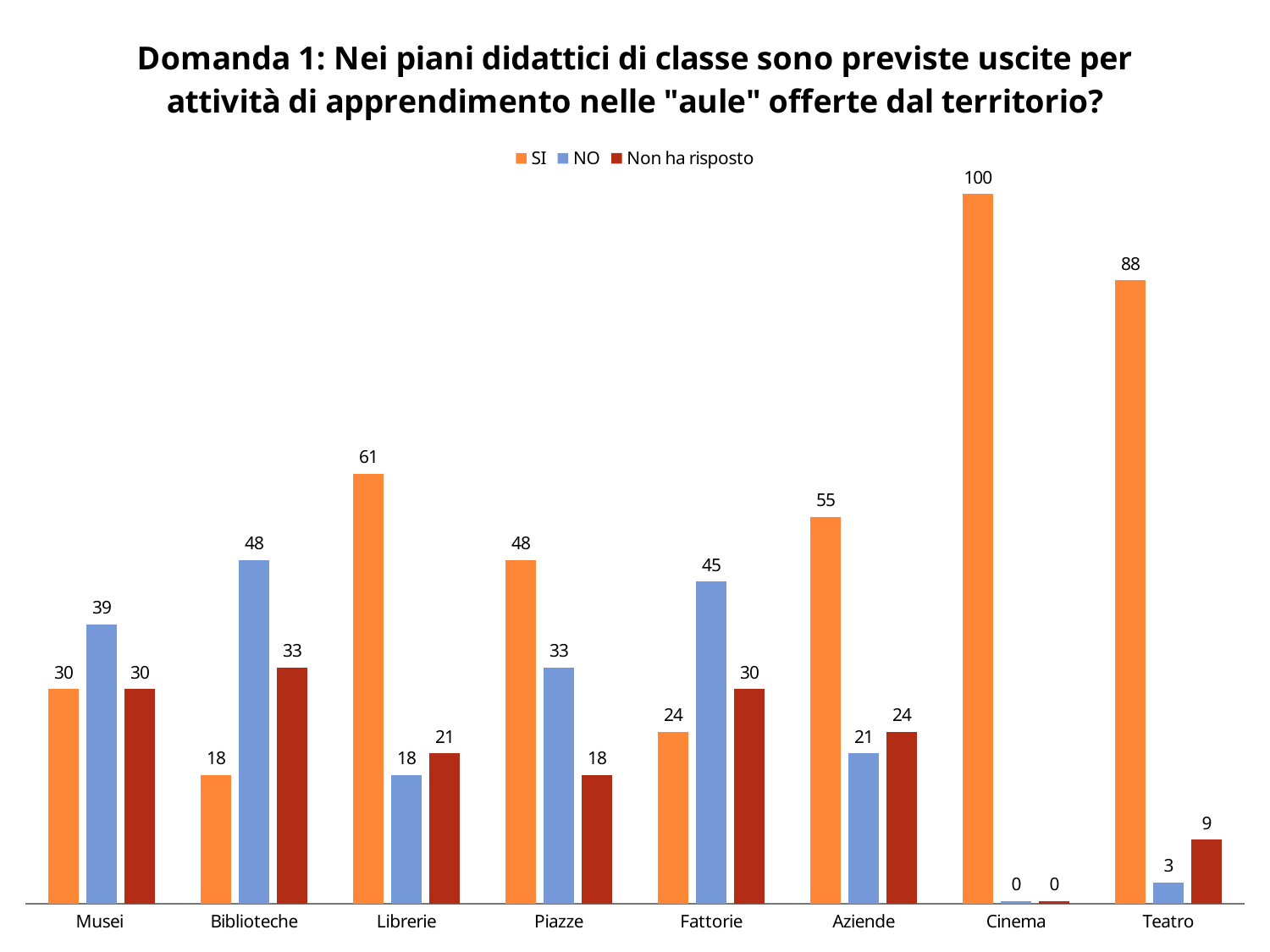
What is the difference between the SI value for Teatro and the SI value for Aziende? 33 How many series does the legend list? 3 Which series is shown in orange in the legend? SI Which category has the lowest NO value? Cinema Which is larger for Piazze, the SI value or the NO value? SI What kind of chart is shown on the slide? Bar chart What is the NO value for Fattorie? 45 Which category has the highest SI value? Cinema What is the SI value for Librerie? 61 What is the total of the three values for Musei? 99 What is the Non ha risposto value for Biblioteche? 33 How many categories are shown on the x axis? 8